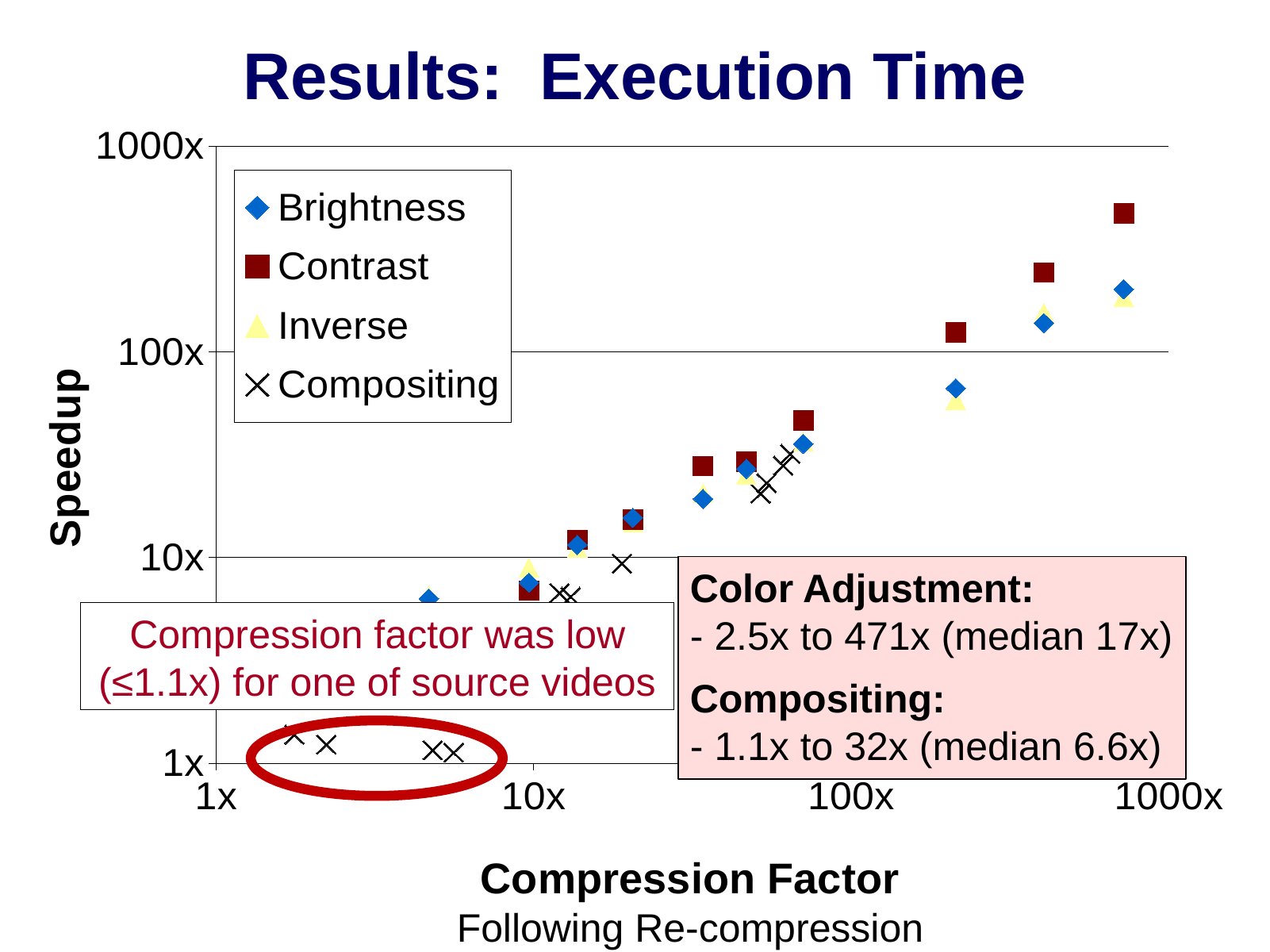
Does speedup rise or fall as the compression factor increases along the x axis? rise Which series are listed in the chart legend? Brightness, Contrast, Inverse, Compositing What is the highest value shown on the vertical axis? 1000x What kind of chart is shown on the slide? scatter chart Is the highest Compositing speedup greater or less than 100x? less Is the highest Contrast speedup greater or less than 100x? greater At the highest compression factor plotted, which series has the larger speedup, Contrast or Brightness? Contrast What is the label of the vertical axis? Speedup Are the Compositing points inside the red circle greater or less than 10x speedup? less Which series has the lowest speedup values on the chart? Compositing Which series reaches the highest speedup on the chart? Contrast How many series does the chart legend list? 4